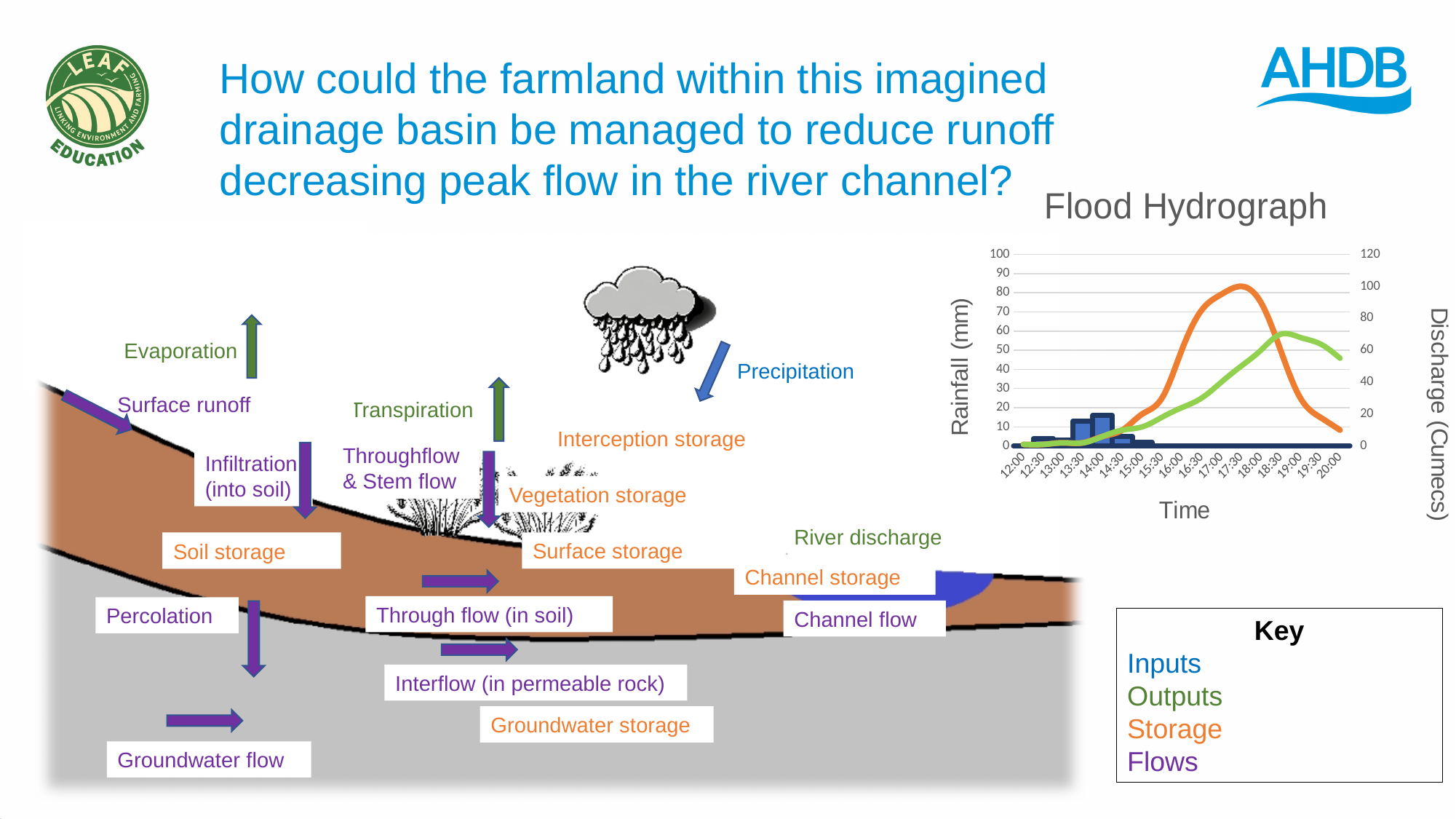
On the Flood Hydrograph, is the orange line's value at 20:00 greater or less than 20 on the discharge axis? less On the Flood Hydrograph, is the tallest rainfall bar greater or less than 10 on the rainfall axis? greater On the Flood Hydrograph, which line is higher at 19:30, the orange line or the green line? The green line On the Flood Hydrograph, is the peak of the green line greater or less than 80 on the discharge axis? less What is the title of the chart on the slide? Flood Hydrograph At what time does the orange line on the Flood Hydrograph reach its highest value? 17:30 What is the label of the right-hand vertical axis of the Flood Hydrograph? Discharge (Cumecs) What kind of chart is the Flood Hydrograph? A combined bar and line chart On the Flood Hydrograph, does the orange line rise or fall between 17:30 and 20:00? Fall On the Flood Hydrograph, which line is higher at 17:30, the orange line or the green line? The orange line How many time points are labelled along the x axis of the Flood Hydrograph? 17